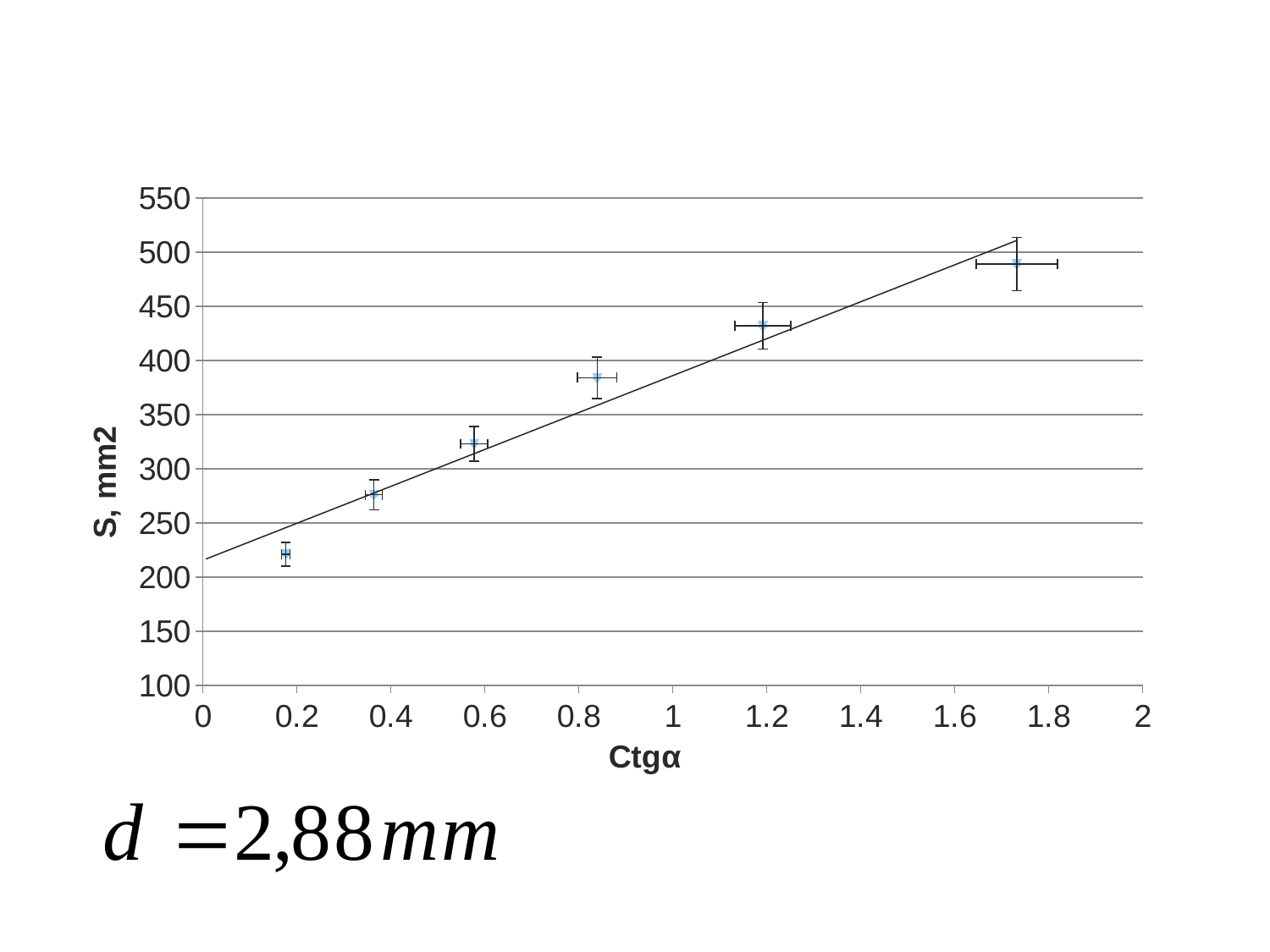
Is the S value for the data point near Ctgα = 0.8 greater or less than 350? greater What is the label of the horizontal axis? Ctgα How many data points are plotted on the chart? 6 Which data point has the highest S value: the one at the smallest Ctgα or the one at the largest Ctgα? the one at the largest Ctgα Do the values of S rise or fall as Ctgα increases along the x axis? rise Is the S value for the data point near Ctgα = 0.4 greater or less than 300? less What kind of chart is shown on the slide? scatter chart Is the S value for the data point near Ctgα = 1.2 greater or less than 400? greater Which has the larger S value: the data point near Ctgα = 0.6 or the data point near Ctgα = 1.2? the data point near Ctgα = 1.2 Which data point has the lowest S value: the one at the smallest Ctgα or the one at the largest Ctgα? the one at the smallest Ctgα What is the label of the vertical axis? S, mm2